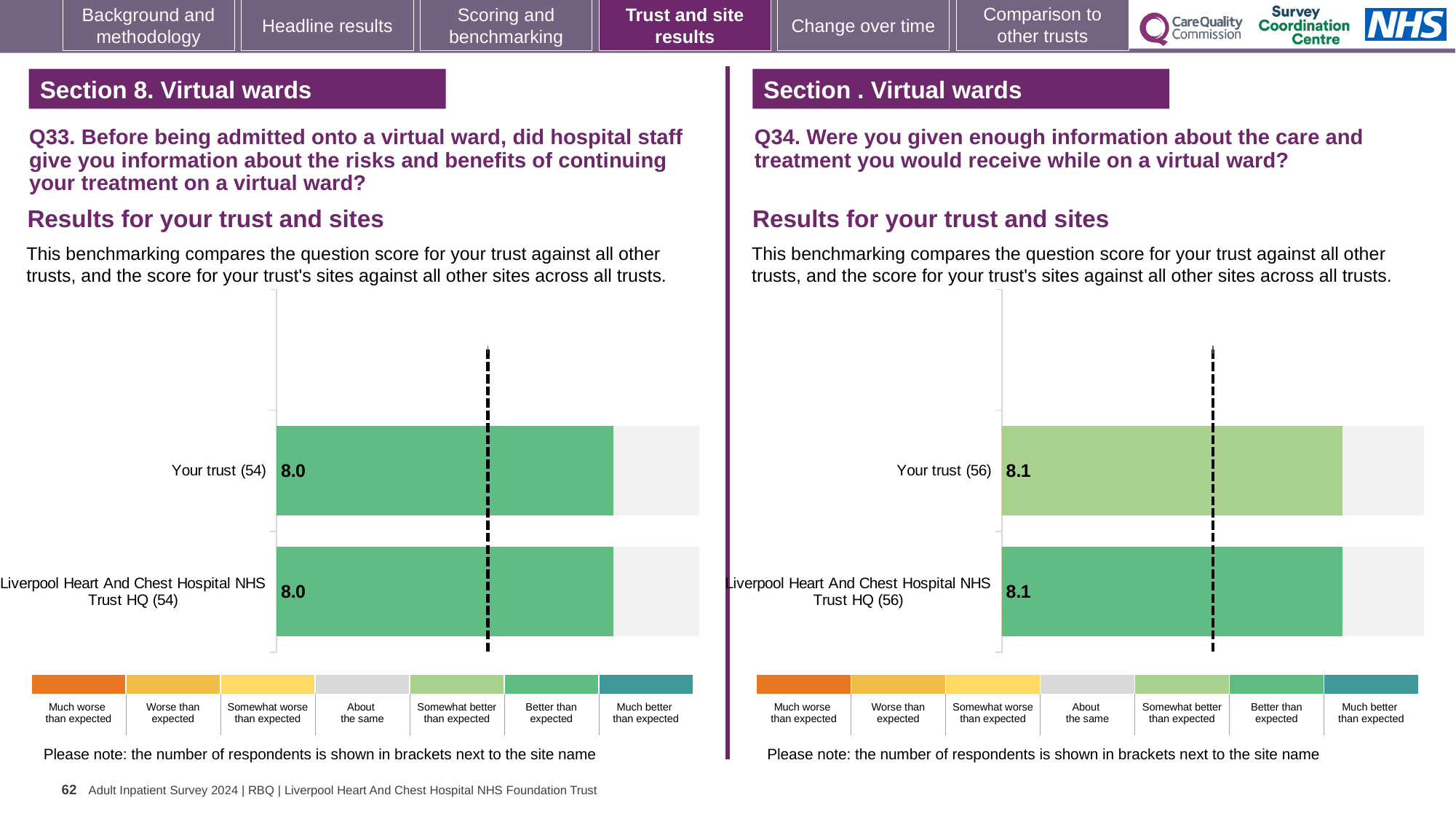
How many bars are plotted on the Q33 chart (left)? 2 On the Q33 chart (left), how many respondents are shown in brackets for Your trust? 54 How many bars are plotted on the Q34 chart (right)? 2 On the Q33 chart (left), what is the score for Your trust (54)? 8.0 On the Q33 chart (left), what is the score for Liverpool Heart And Chest Hospital NHS Trust HQ (54)? 8.0 On the Q34 chart (right), which benchmark category does the colour of the Your trust (56) bar correspond to? Somewhat better than expected On the Q34 chart (right), what is the score for Liverpool Heart And Chest Hospital NHS Trust HQ (56)? 8.1 What type of chart is used on the Q33 chart (left)? Bar chart Is the score for Your trust on the Q34 chart (right) greater or less than the score for Your trust on the Q33 chart (left)? greater On the Q33 chart (left), what is the difference between the score for Your trust and the score for Liverpool Heart And Chest Hospital NHS Trust HQ? 0.0 On the Q34 chart (right), what is the difference between the score for Your trust and the score for Liverpool Heart And Chest Hospital NHS Trust HQ? 0.0 On the Q34 chart (right), what is the score for Your trust (56)? 8.1